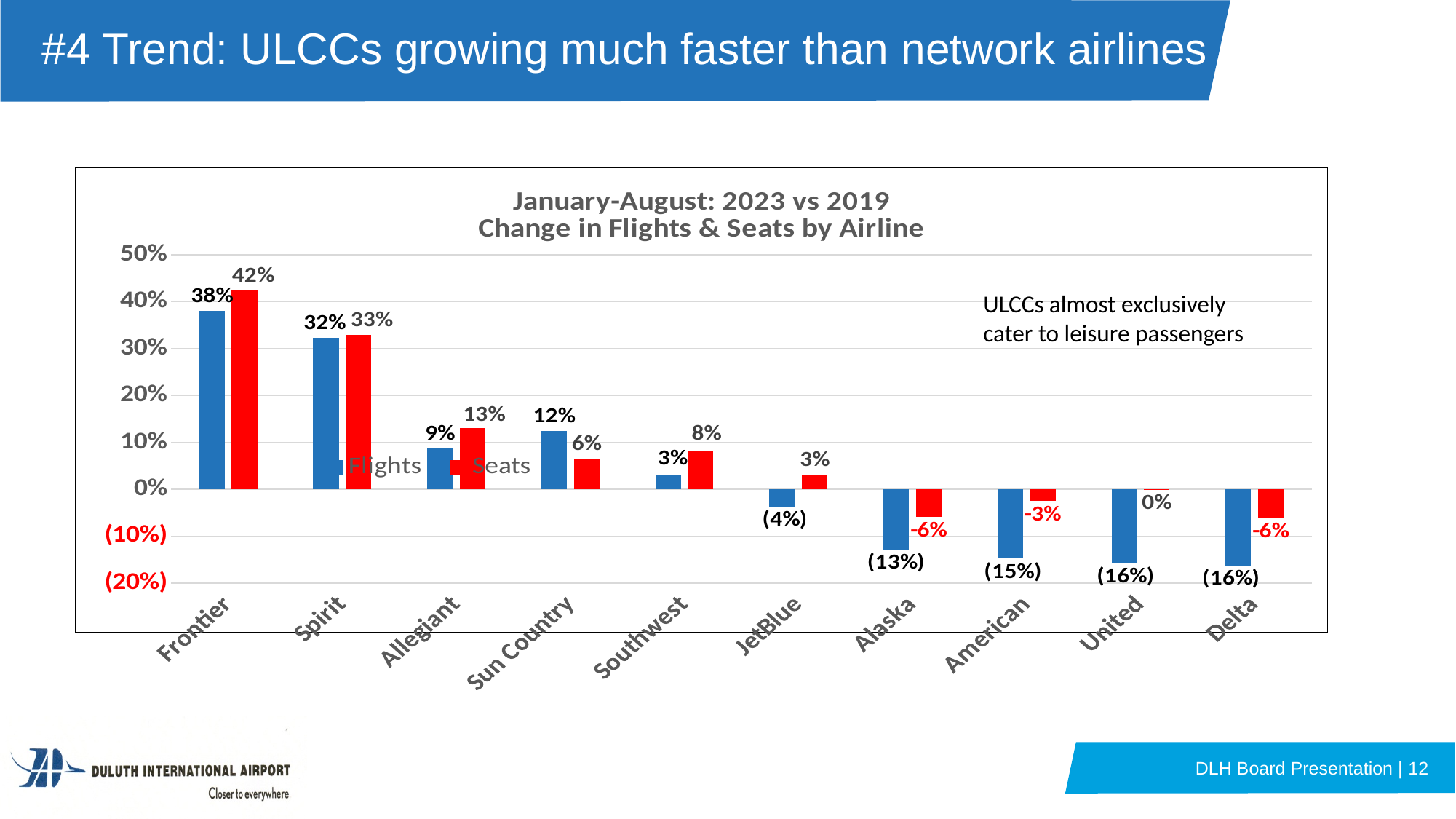
How many series does the legend list? 2 What is the Flights value for Frontier? 38% What is the Flights value for JetBlue? (4%) What is the difference between the Seats and Flights values for Frontier? 4 percentage points Which airline has the highest Flights value? Frontier For Sun Country, which is larger: the Flights value or the Seats value? Flights Do the Flights values generally rise or fall moving from Frontier to Delta along the x axis? Fall What kind of chart is shown on the slide? Bar chart What is the Seats value for Allegiant? 13% How many airlines are shown on the x axis? 10 What is the Seats value for United? 0% Which airline has the highest Seats value? Frontier